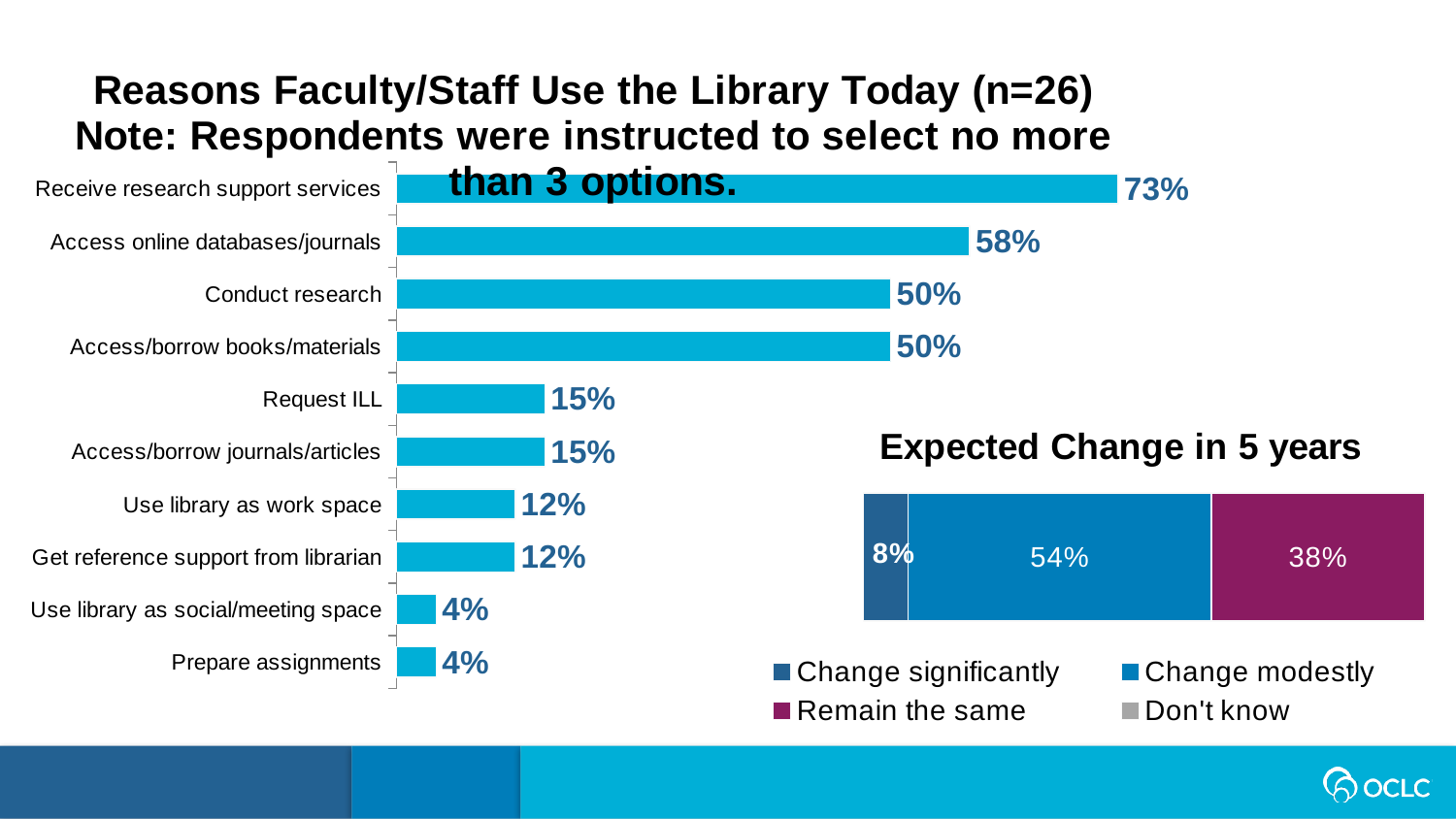
In the 'Reasons Faculty/Staff Use the Library Today' chart, what is the difference between 'Receive research support services' and 'Access online databases/journals'? 15% In the 'Expected Change in 5 years' chart, what is the total of the three labelled segments (8%, 54% and 38%)? 100% How many reasons are listed in the 'Reasons Faculty/Staff Use the Library Today' chart? 10 In the 'Reasons Faculty/Staff Use the Library Today' chart, what percentage is shown for 'Request ILL'? 15% In the 'Reasons Faculty/Staff Use the Library Today' chart, which is larger: 'Use library as work space' or 'Use library as social/meeting space'? Use library as work space In the 'Reasons Faculty/Staff Use the Library Today' chart, what percentage is shown for 'Access online databases/journals'? 58% In the 'Reasons Faculty/Staff Use the Library Today' chart, which reason has the highest percentage? Receive research support services How many series does the legend of the 'Expected Change in 5 years' chart list? 4 In the 'Reasons Faculty/Staff Use the Library Today' chart, what percentage is shown for 'Receive research support services'? 73% What kind of chart is 'Reasons Faculty/Staff Use the Library Today'? Bar chart In the 'Expected Change in 5 years' chart, what percentage is shown for 'Remain the same'? 38% In the 'Expected Change in 5 years' chart, what percentage is shown for 'Change modestly'? 54%